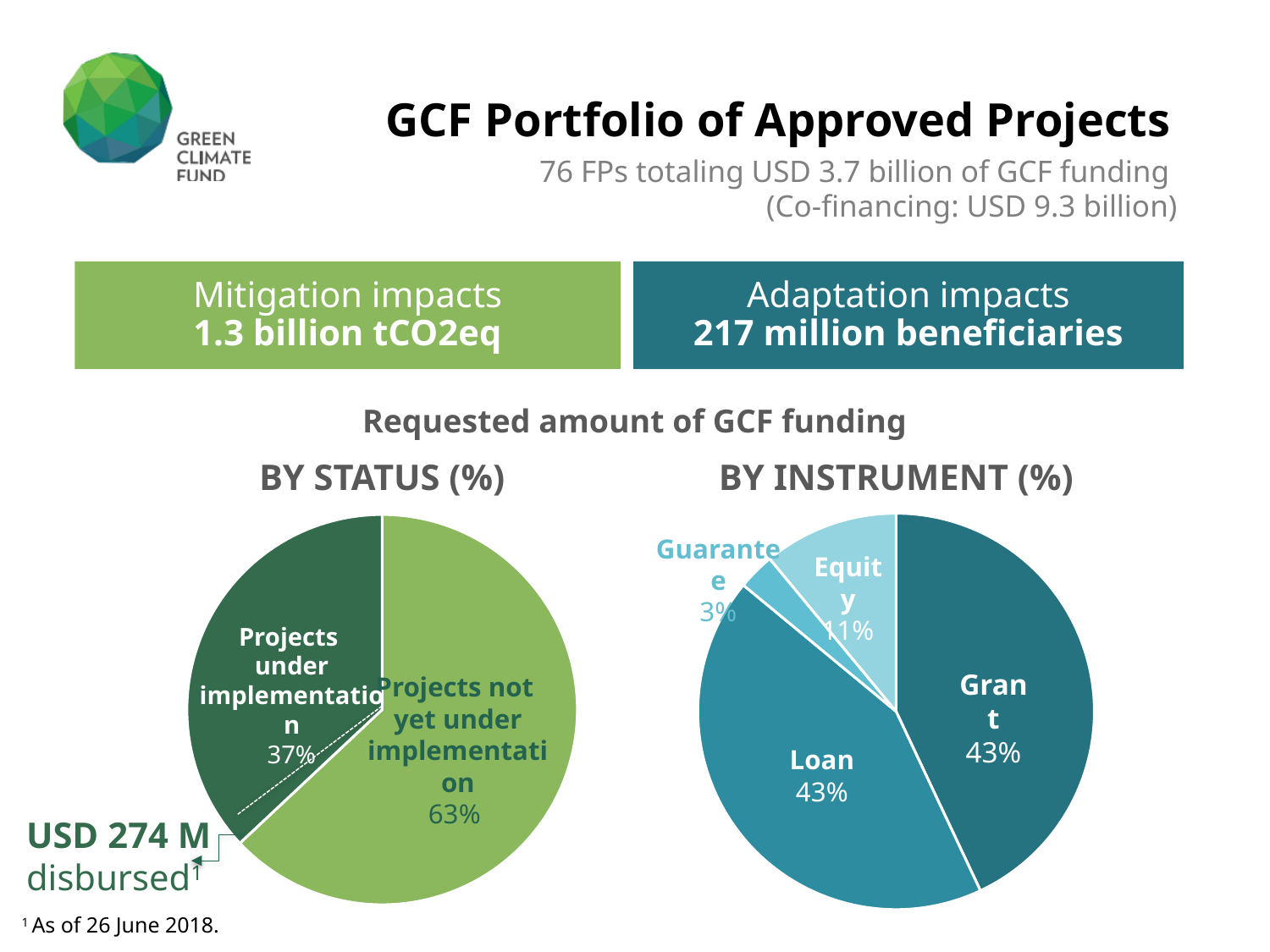
In the BY STATUS (%) chart, what share of requested GCF funding is for projects under implementation? 37% In the BY INSTRUMENT (%) chart, which is larger, the share for Equity or the share for Guarantee? Equity In the BY STATUS (%) chart, what share of requested GCF funding is for projects not yet under implementation? 63% What kind of chart is the BY STATUS (%) chart? Pie chart In the BY INSTRUMENT (%) chart, what share of requested GCF funding is in the form of loans? 43% In the BY STATUS (%) chart, what is the difference in percentage points between projects not yet under implementation and projects under implementation? 26 In the BY STATUS (%) chart, which category has the larger share? Projects not yet under implementation In the BY INSTRUMENT (%) chart, how many instrument categories are shown? 4 In the BY INSTRUMENT (%) chart, what is the difference in percentage points between the Grant share and the Equity share? 32 In the BY INSTRUMENT (%) chart, which instrument has the smallest share? Guarantee In the BY INSTRUMENT (%) chart, what share of requested GCF funding is guarantees? 3% In the BY INSTRUMENT (%) chart, what share of requested GCF funding is equity? 11%